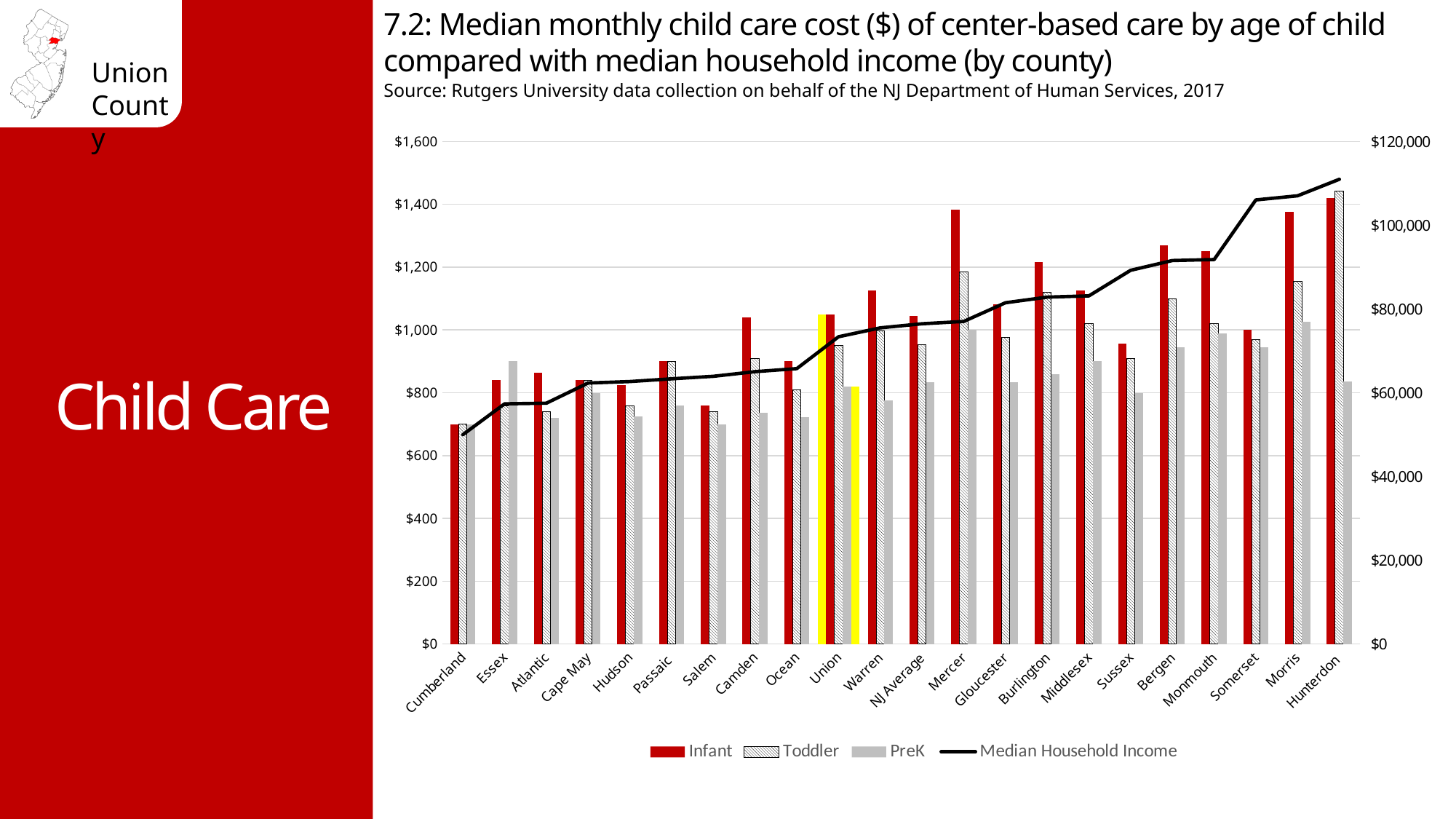
Is the Infant cost for Cumberland greater or less than $800? less Which county's bars are highlighted in yellow? Union Which category has the highest Median Household Income? Hunterdon Is the Infant cost for Mercer greater or less than $1,200? greater Does the Median Household Income line generally rise or fall from left to right across the counties? Rise How many series does the legend list? 4 Which category has the lowest Infant cost? Cumberland What kind of chart is shown on the slide? Bar chart with a line How many counties/categories are shown along the x axis? 22 Which is larger, the Infant cost for Mercer or the Infant cost for Sussex? Mercer Is the Infant cost for Union greater or less than $1,000? greater Which category has the highest Toddler cost? Hunterdon